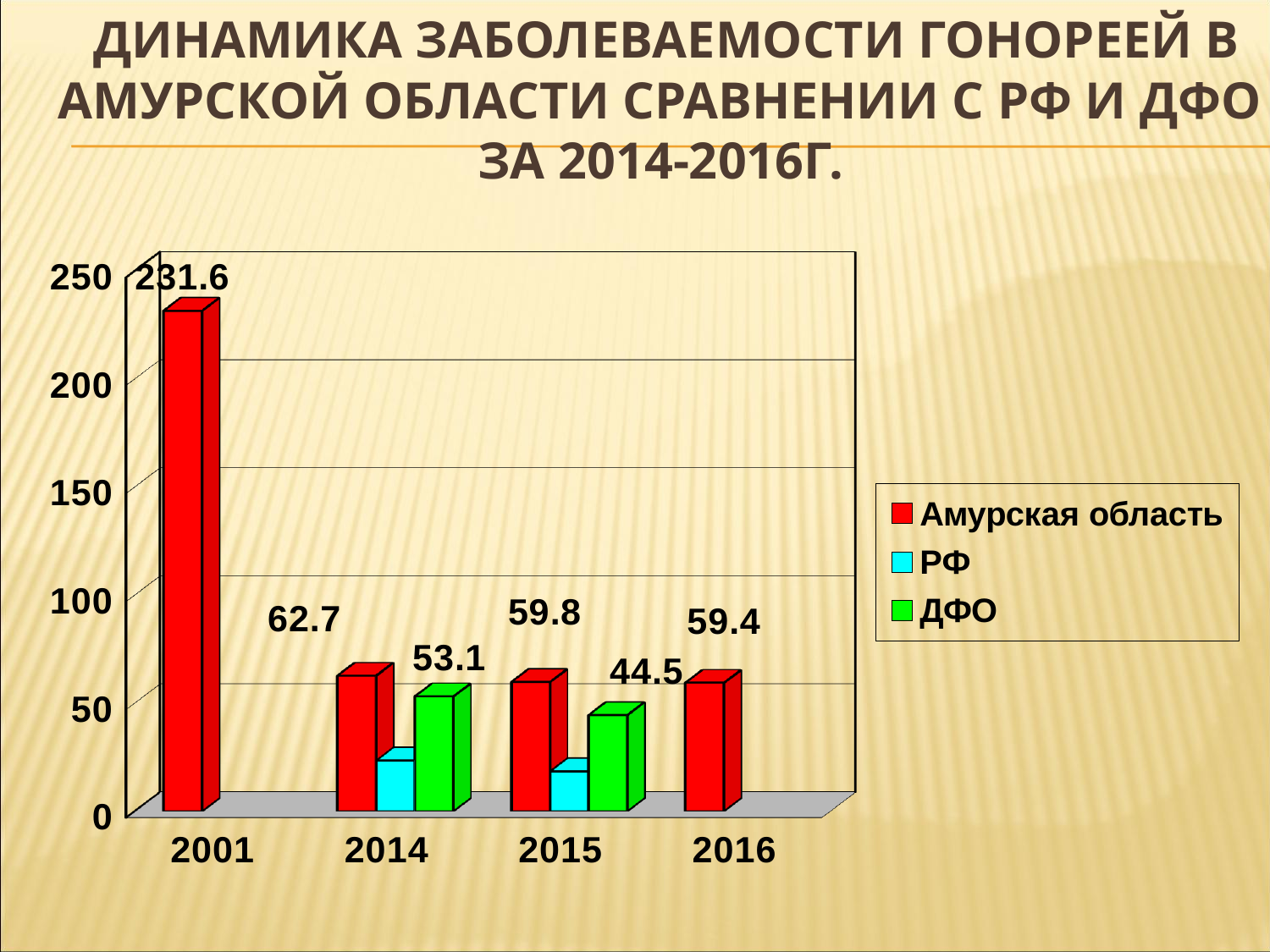
In which year is the value for Амурская область the highest? 2001 How many series does the legend list? 3 What is the value for Амурская область in 2014? 62.7 Do the values for Амурская область rise or fall from 2014 to 2016? fall By how much did the ДФО value change from 2014 to 2015? 8.6 What is the value for ДФО in 2015? 44.5 Is the value for РФ in 2014 greater or less than 50? less What is the difference between the Амурская область value and the ДФО value in 2014? 9.6 What is the value for ДФО in 2014? 53.1 What is the value for Амурская область in 2016? 59.4 In 2015, which is larger: the value for Амурская область or the value for ДФО? Амурская область What is the value for Амурская область in 2001? 231.6